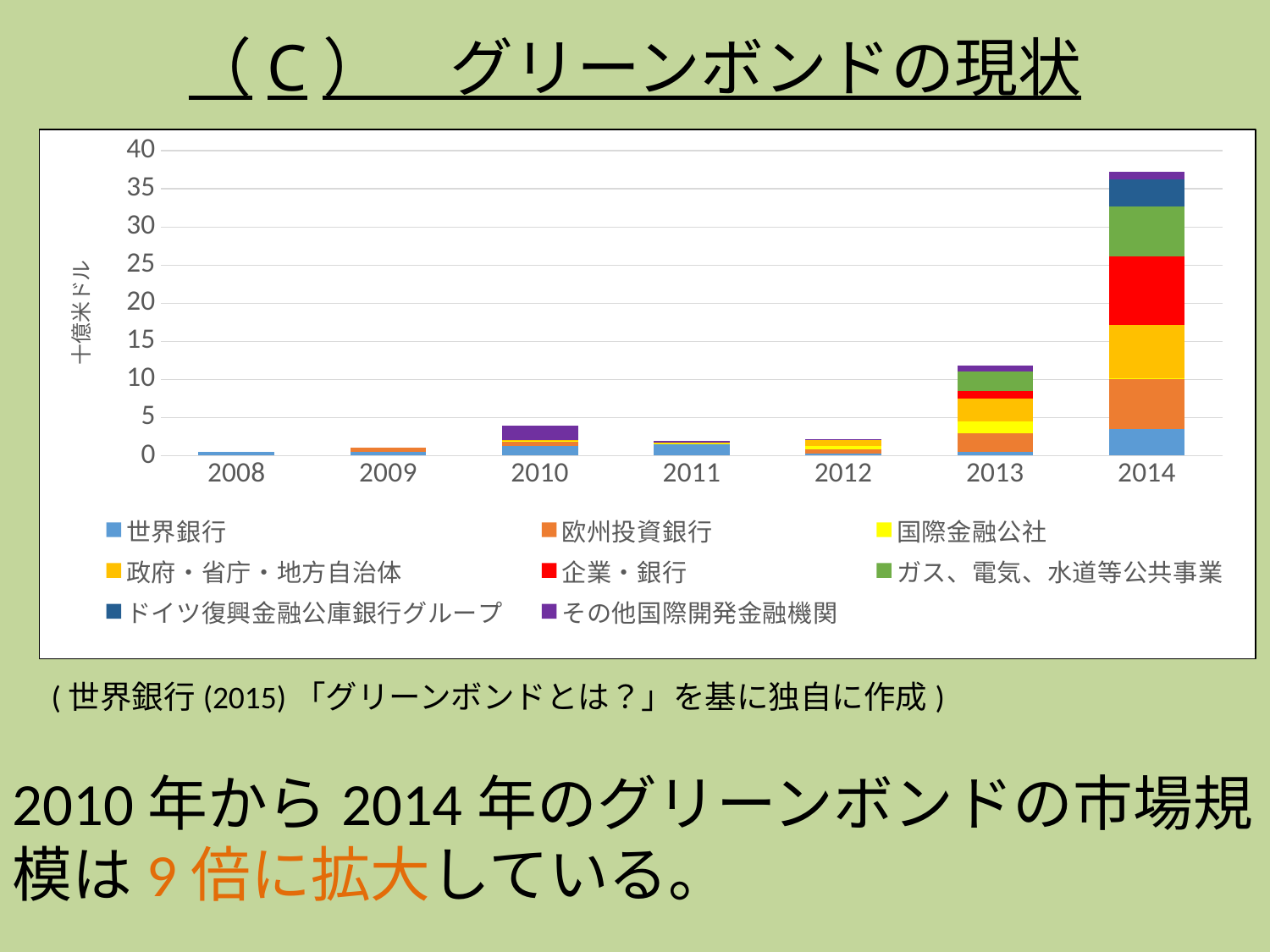
Do the total stacked values rise or fall from 2012 to 2014? rise Which year has the shortest stacked bar? 2008 How many series does the chart's legend list? 8 What kind of chart is shown on the slide? Stacked bar chart Is the total stacked value for 2013 greater or less than 10? greater Which year has the tallest stacked bar? 2014 Which legend entry is shown in red? 企業・銀行 Which year has the larger total stacked bar, 2013 or 2012? 2013 Is the total stacked value for 2014 greater or less than 35? greater Is the total stacked value for 2012 greater or less than 5? less What unit is shown on the y axis label of the chart? 十億米ドル How many years are shown on the x axis of the chart? 7